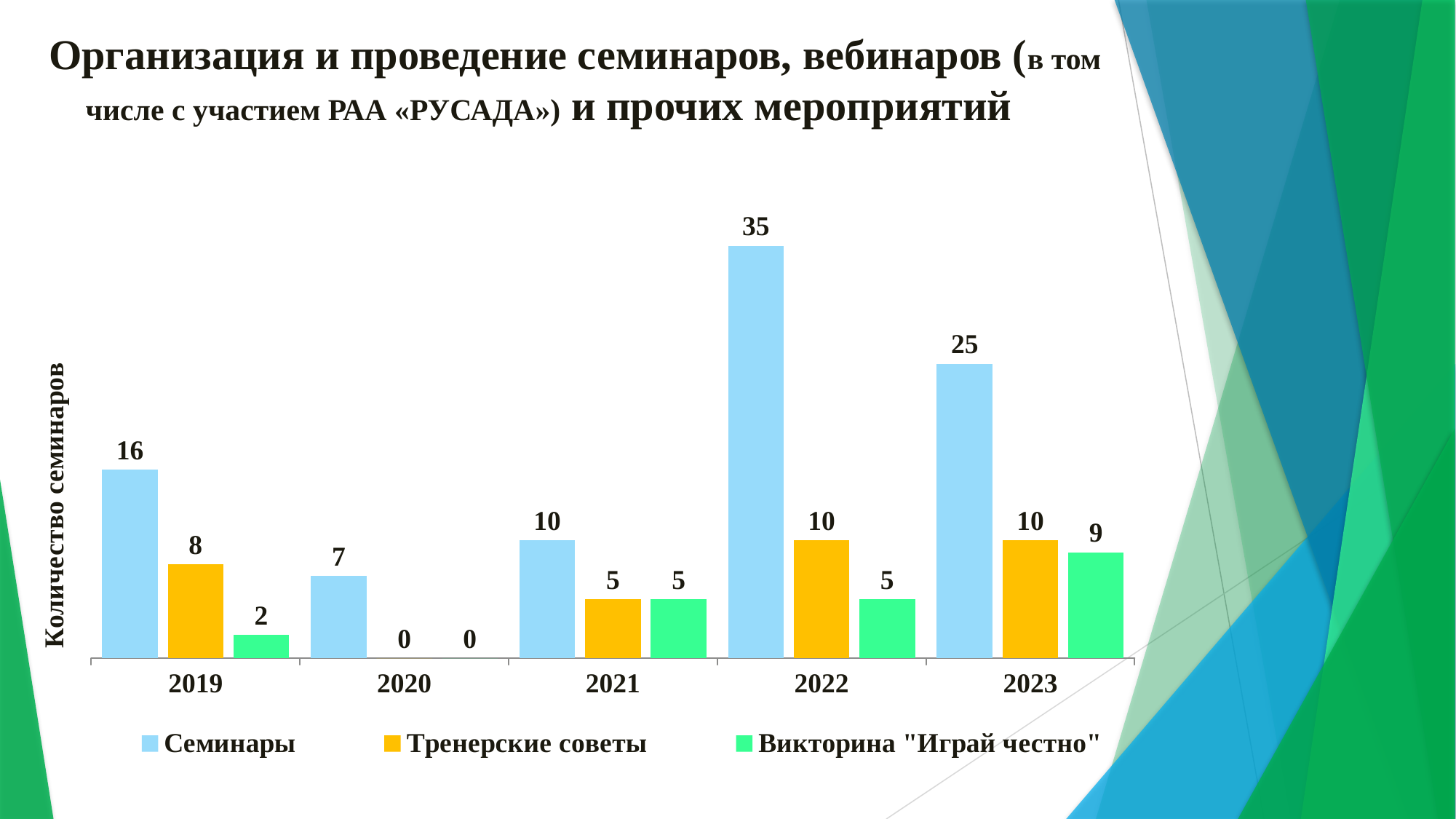
What is the value for Викторина "Играй честно" in 2023? 9 What kind of chart is shown on the slide? Bar chart Which is larger: Тренерские советы in 2021 or Тренерские советы in 2022? Тренерские советы in 2022 What is the value for Тренерские советы in 2019? 8 What is the label of the vertical axis? Количество семинаров In which year is the value for Семинары highest? 2022 What is the value for Семинары in 2022? 35 How many years are shown on the x axis? 5 What is the difference between the Семинары values for 2022 and 2023? 10 Does the value for Викторина "Играй честно" rise or fall from 2020 to 2023? Rise How many series does the legend list? 3 In which year is the value for Семинары lowest? 2020